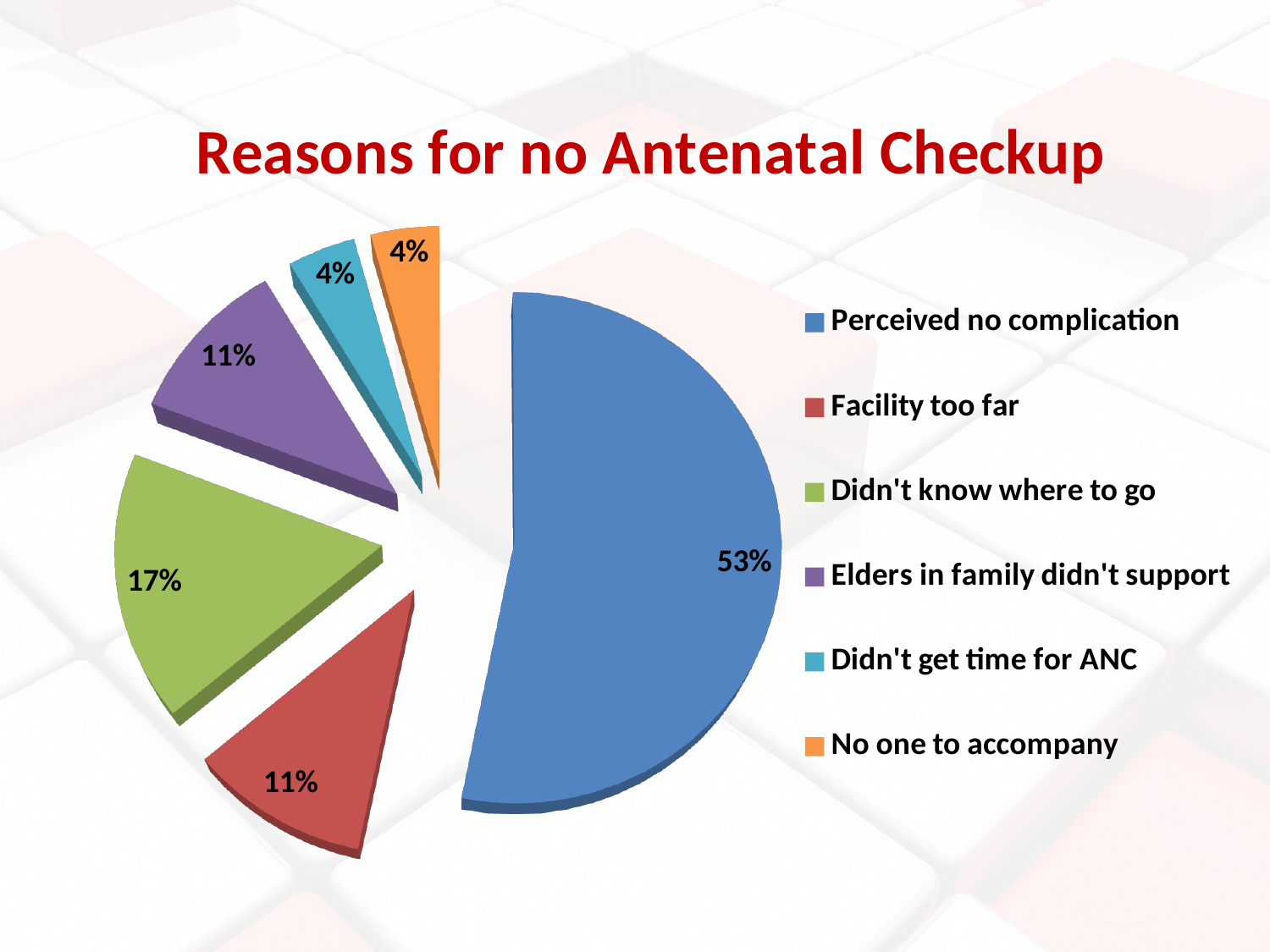
What is the difference between the shares for 'Perceived no complication' and 'Didn't know where to go'? 36% How many categories does the pie chart show? 6 What is the combined share of 'Didn't get time for ANC' and 'No one to accompany'? 8% What is the title of the chart? Reasons for no Antenatal Checkup Which is larger: the share for 'Didn't know where to go' or the share for 'Elders in family didn't support'? Didn't know where to go What share of the pie is 'Facility too far'? 11% What share of the pie is 'Perceived no complication'? 53% What kind of chart is shown on the slide? Pie chart What share of the pie is 'Didn't know where to go'? 17% What share of the pie is 'No one to accompany'? 4% Which colour represents 'Didn't get time for ANC' in the legend? Light blue Which reason has the largest share of the pie? Perceived no complication